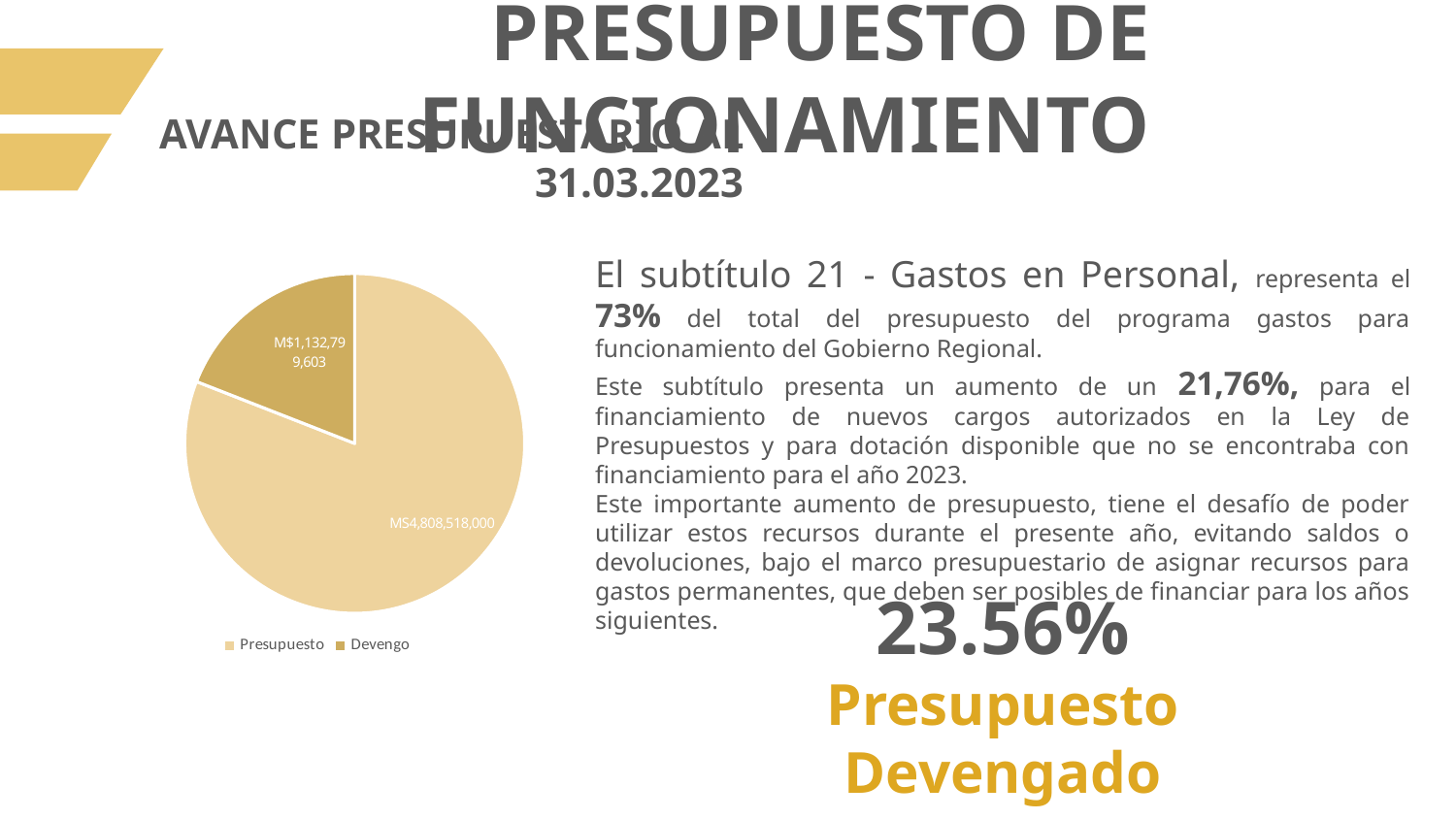
What value is shown for Devengo in the pie chart? M$1,132,799,603 What kind of chart is shown on the slide? pie chart What are the two legend entries of the pie chart? Presupuesto and Devengo Which legend entry of the pie chart is shown in the darker gold colour? Devengo What value is shown for Presupuesto in the pie chart? M$4,808,518,000 Which slice of the pie chart is the smallest? Devengo How many slices does the pie chart have? 2 Which is larger in the pie chart, Presupuesto or Devengo? Presupuesto What is the difference between the Presupuesto value and the Devengo value in the pie chart? M$3,675,718,397 How many entries does the legend of the pie chart list? 2 Which slice of the pie chart is the largest? Presupuesto